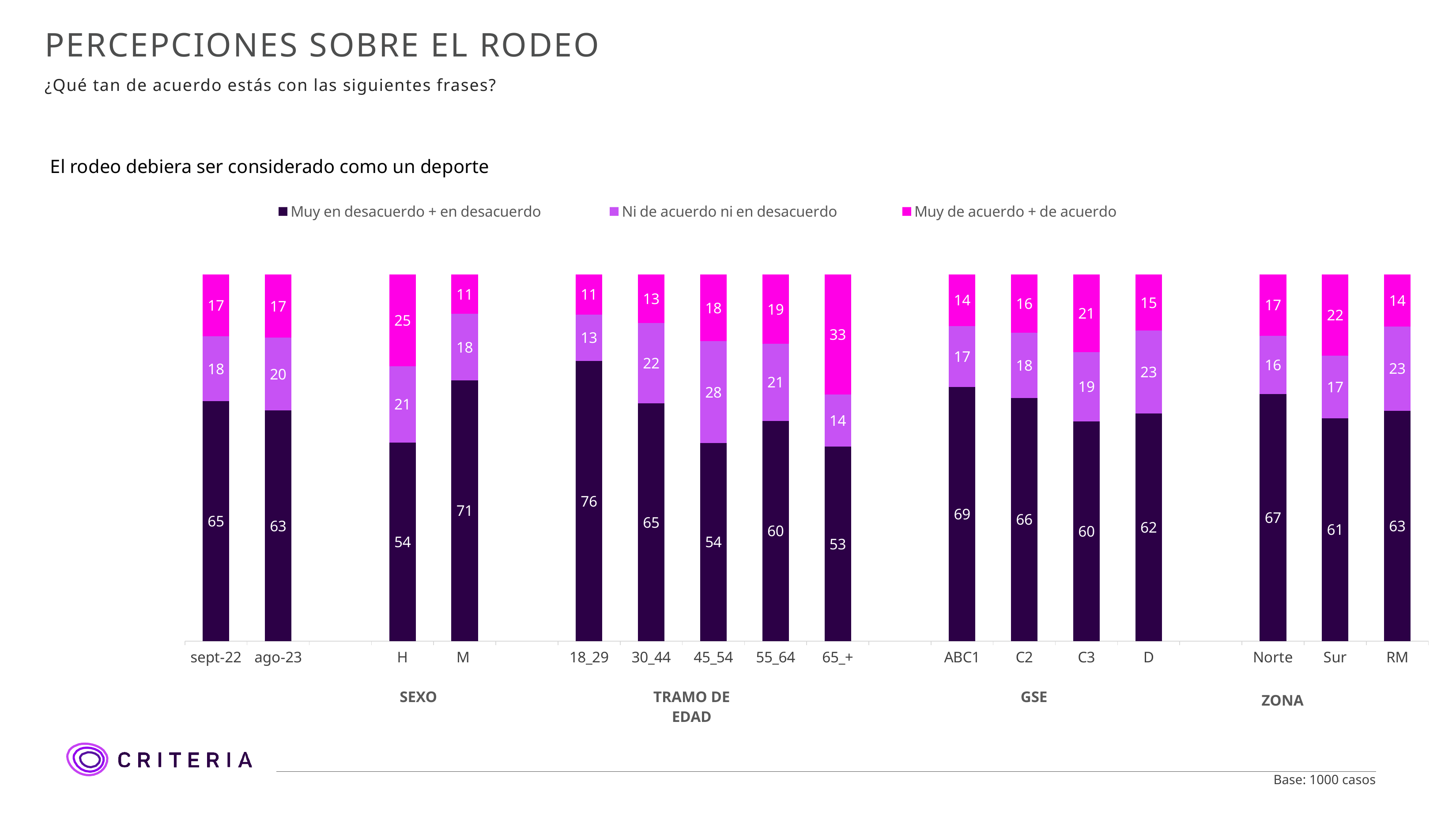
How many categories (bars) are shown on the x axis? 16 What is the total of the stacked bar for sept-22? 100 What kind of chart is shown on the slide? Stacked bar chart How many series does the legend list? 3 Which category has the highest value for "Muy de acuerdo + de acuerdo"? 65_+ What is the value of "Muy de acuerdo + de acuerdo" for the 65_+ category? 33 What is the value of "Muy en desacuerdo + en desacuerdo" for the 18_29 category? 76 What is the value of "Ni de acuerdo ni en desacuerdo" for the 45_54 category? 28 Which has a larger value for "Muy de acuerdo + de acuerdo", Norte or Sur? Sur What is the difference between M and H in "Muy en desacuerdo + en desacuerdo"? 17 What statement is the chart about, as shown in the heading above the chart? El rodeo debiera ser considerado como un deporte Which category has the lowest value for "Muy en desacuerdo + en desacuerdo"? 65_+